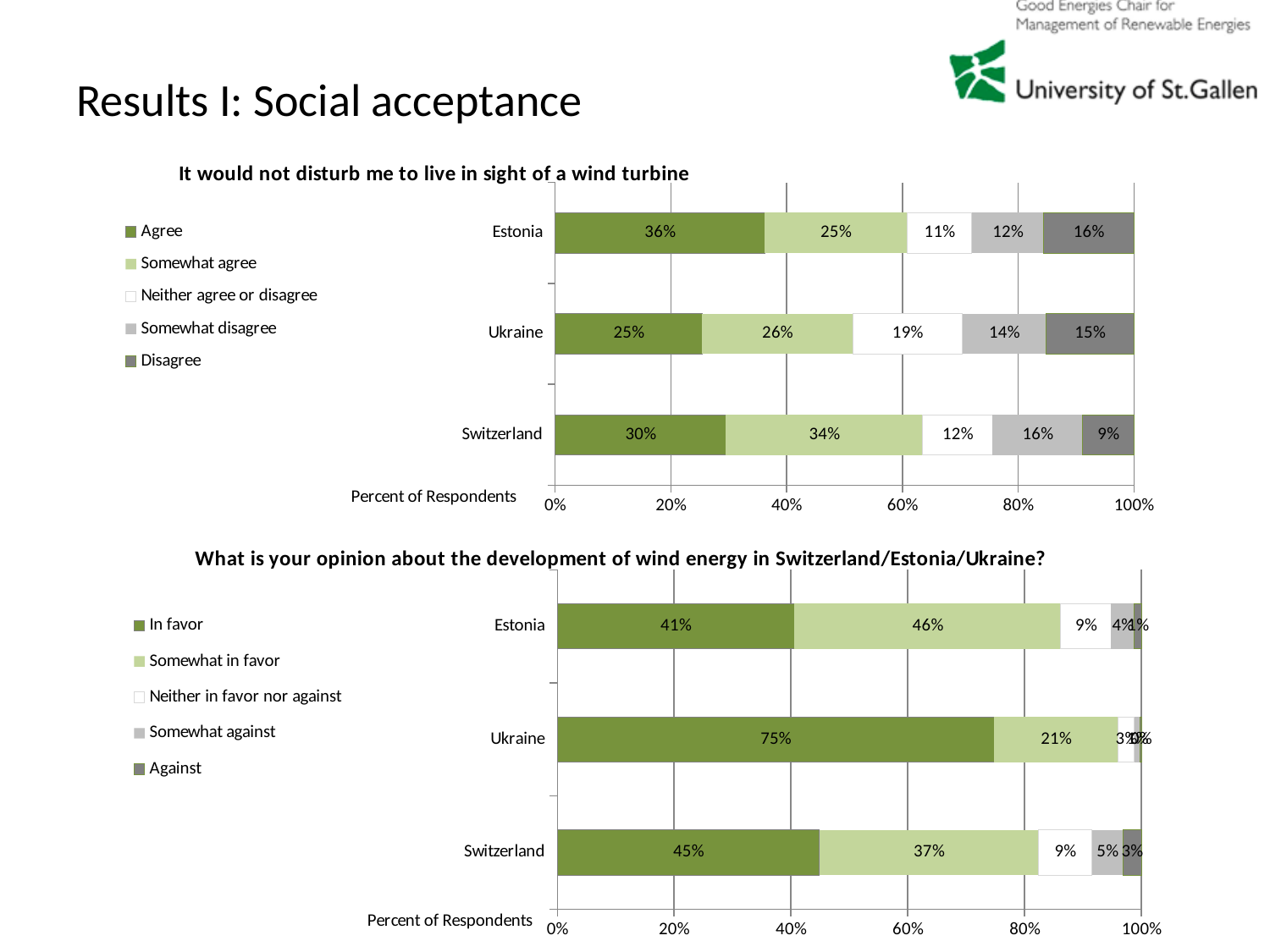
How many countries are shown in the chart titled "It would not disturb me to live in sight of a wind turbine"? 3 In the chart titled "It would not disturb me to live in sight of a wind turbine", which country has the highest "Agree" share? Estonia In the chart titled "What is your opinion about the development of wind energy in Switzerland/Estonia/Ukraine?", is the "In favor" value for Switzerland larger or smaller than the "In favor" value for Estonia? larger In the chart titled "It would not disturb me to live in sight of a wind turbine", what percentage of Estonian respondents chose "Agree"? 36% What type of chart is used for "What is your opinion about the development of wind energy in Switzerland/Estonia/Ukraine?"? Stacked bar chart In the chart titled "It would not disturb me to live in sight of a wind turbine", what is the difference between the "Agree" values for Estonia and Ukraine? 11 percentage points In the chart titled "It would not disturb me to live in sight of a wind turbine", what is the "Somewhat agree" value for Switzerland? 34% In the chart titled "What is your opinion about the development of wind energy in Switzerland/Estonia/Ukraine?", what percentage of Ukrainian respondents are "In favor"? 75% In the chart titled "What is your opinion about the development of wind energy in Switzerland/Estonia/Ukraine?", how many series does the legend list? 5 In the chart titled "It would not disturb me to live in sight of a wind turbine", which country has the lowest "Disagree" share? Switzerland In the chart titled "What is your opinion about the development of wind energy in Switzerland/Estonia/Ukraine?", what is the "Somewhat in favor" value for Estonia? 46% In the chart titled "It would not disturb me to live in sight of a wind turbine", what is the "Neither agree or disagree" value for Ukraine? 19%